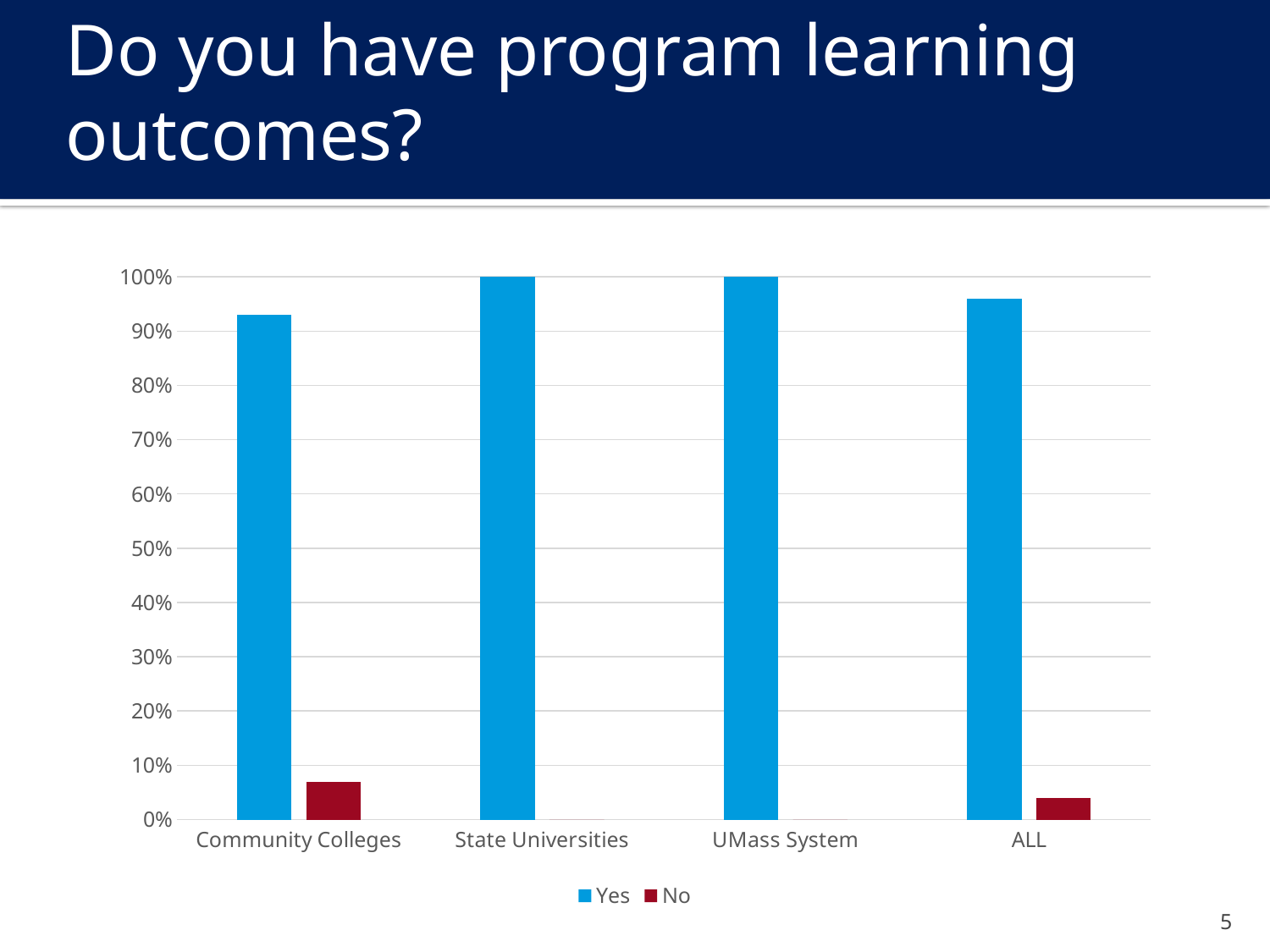
What are the two series named in the legend? Yes and No What is the Yes value for State Universities? 100% Is the No value for ALL greater or less than 10%? less Is the Yes value for Community Colleges greater or less than 90%? greater What is the Yes value for UMass System? 100% Which is larger, the Yes value for Community Colleges or the Yes value for ALL? ALL What kind of chart is shown on the slide? bar chart Is the No value for Community Colleges greater or less than 10%? less How many series does the chart's legend list? 2 Which category has the highest No value? Community Colleges How many categories are shown on the x axis of the chart? 4